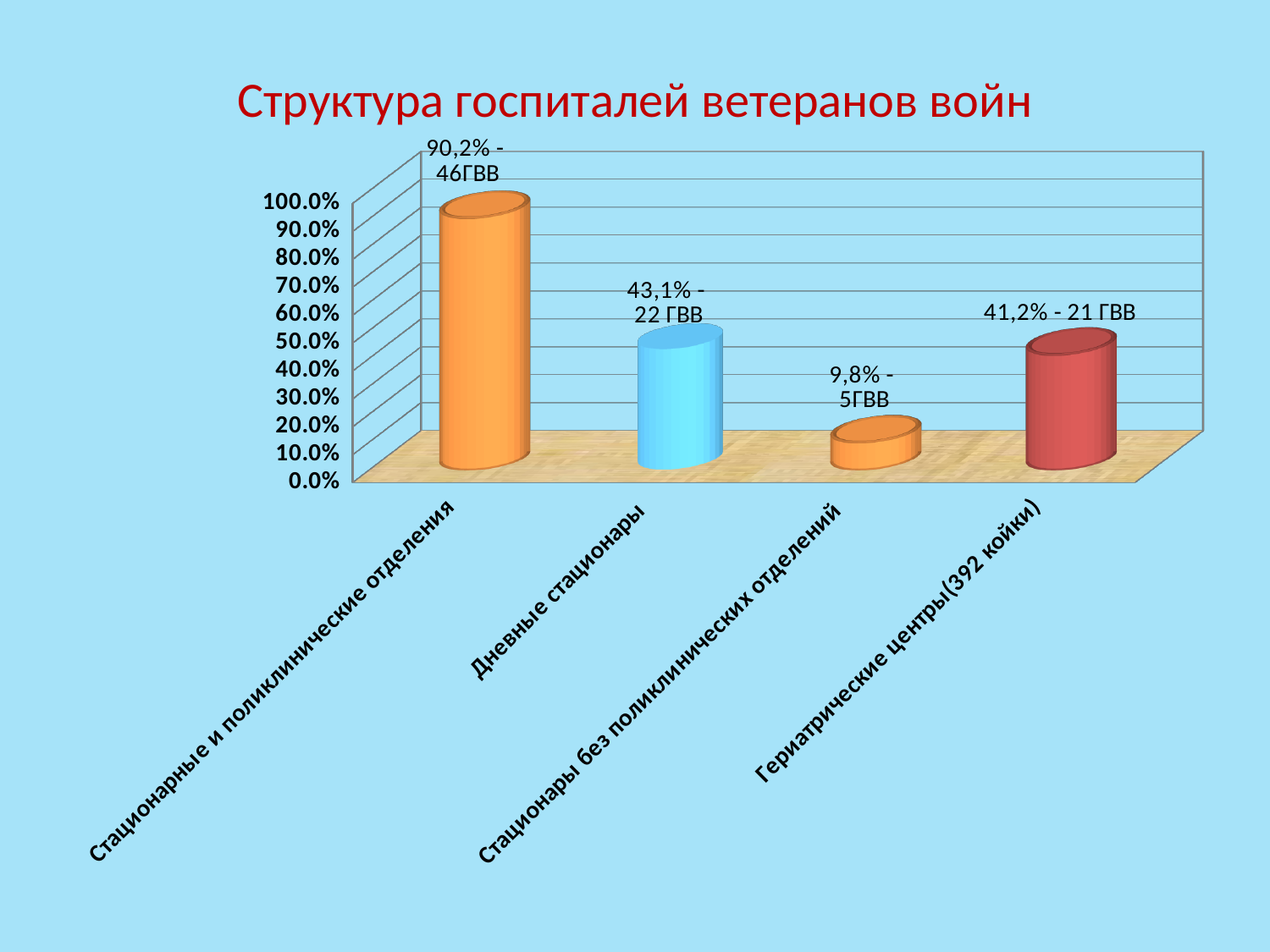
What percentage is shown for Дневные стационары? 43,1% Which category has the highest percentage? Стационарные и поликлинические отделения What kind of chart is shown on the slide? bar chart What is the data label for Гериатрические центры(392 койки)? 41,2% - 21 ГВВ How many ГВВ are indicated for Стационары без поликлинических отделений? 5 Is the value for Стационары без поликлинических отделений greater or less than 20.0%? less Which category has the lowest percentage? Стационары без поликлинических отделений Which is larger: the percentage for Дневные стационары or for Гериатрические центры(392 койки)? Дневные стационары What is the title of the chart? Структура госпиталей ветеранов войн What is the difference in percentage points between Стационарные и поликлинические отделения and Дневные стационары? 47,1 What percentage is shown for Стационарные и поликлинические отделения? 90,2% How many categories are plotted in the chart? 4